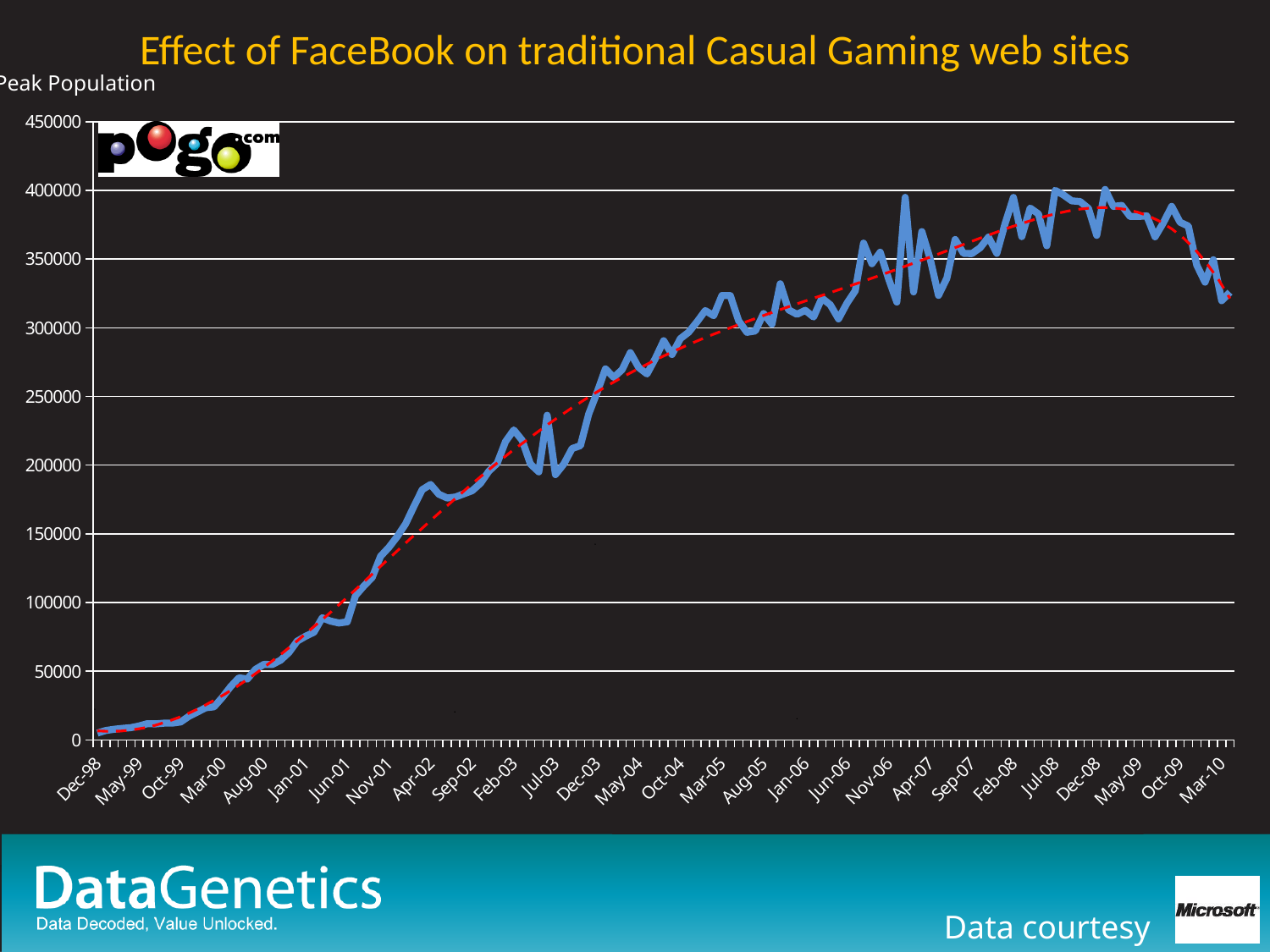
What kind of chart is shown on the slide? line chart Is the value for Apr-02 greater or less than 150000? greater Is the value for Mar-10 greater or less than 300000? greater Does the peak population rise or fall between Dec-98 and Feb-08? rise Is the value for Jun-01 greater or less than 100000? less What is the title of the chart? Effect of FaceBook on traditional Casual Gaming web sites Which x-axis label has the lowest peak population value? Dec-98 What is the label on the vertical axis of the chart? Peak Population Does the peak population rise or fall between Jul-08 and Mar-10? fall